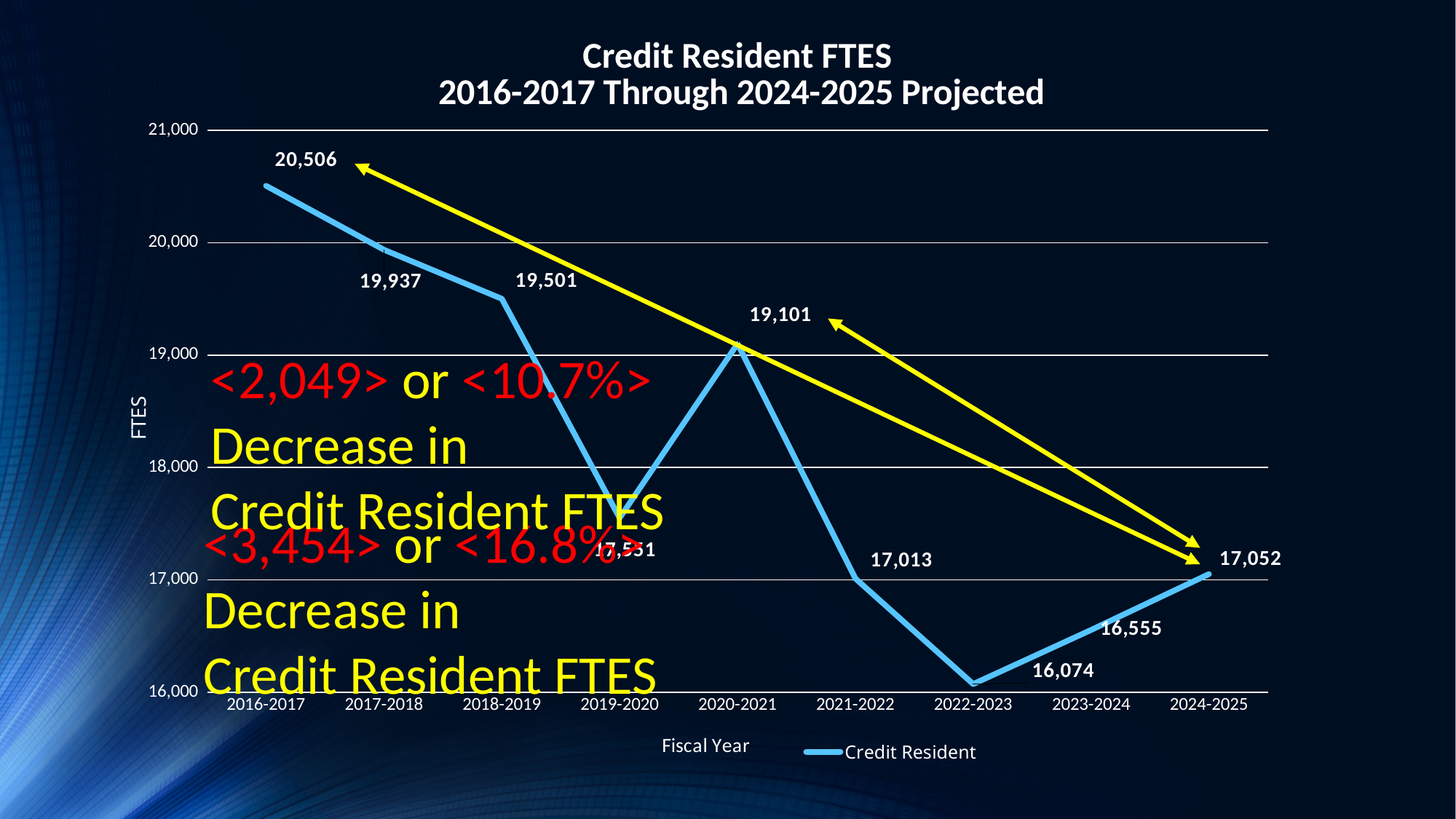
Which fiscal year has the lowest Credit Resident FTES? 2022-2023 How many series does the legend list? 1 What is the Credit Resident FTES value for 2022-2023? 16,074 What kind of chart is shown on the slide? line chart What is the difference in Credit Resident FTES between 2016-2017 and 2024-2025? 3,454 What is the Credit Resident FTES value for 2016-2017? 20,506 Which fiscal year has a higher Credit Resident FTES, 2020-2021 or 2023-2024? 2020-2021 Which fiscal year has the highest Credit Resident FTES? 2016-2017 What is the difference in Credit Resident FTES between 2020-2021 and 2021-2022? 2,088 What is the projected Credit Resident FTES value for 2024-2025? 17,052 How many fiscal years are plotted on the chart? 9 Is the Credit Resident FTES value for 2019-2020 greater or less than 18,000? less